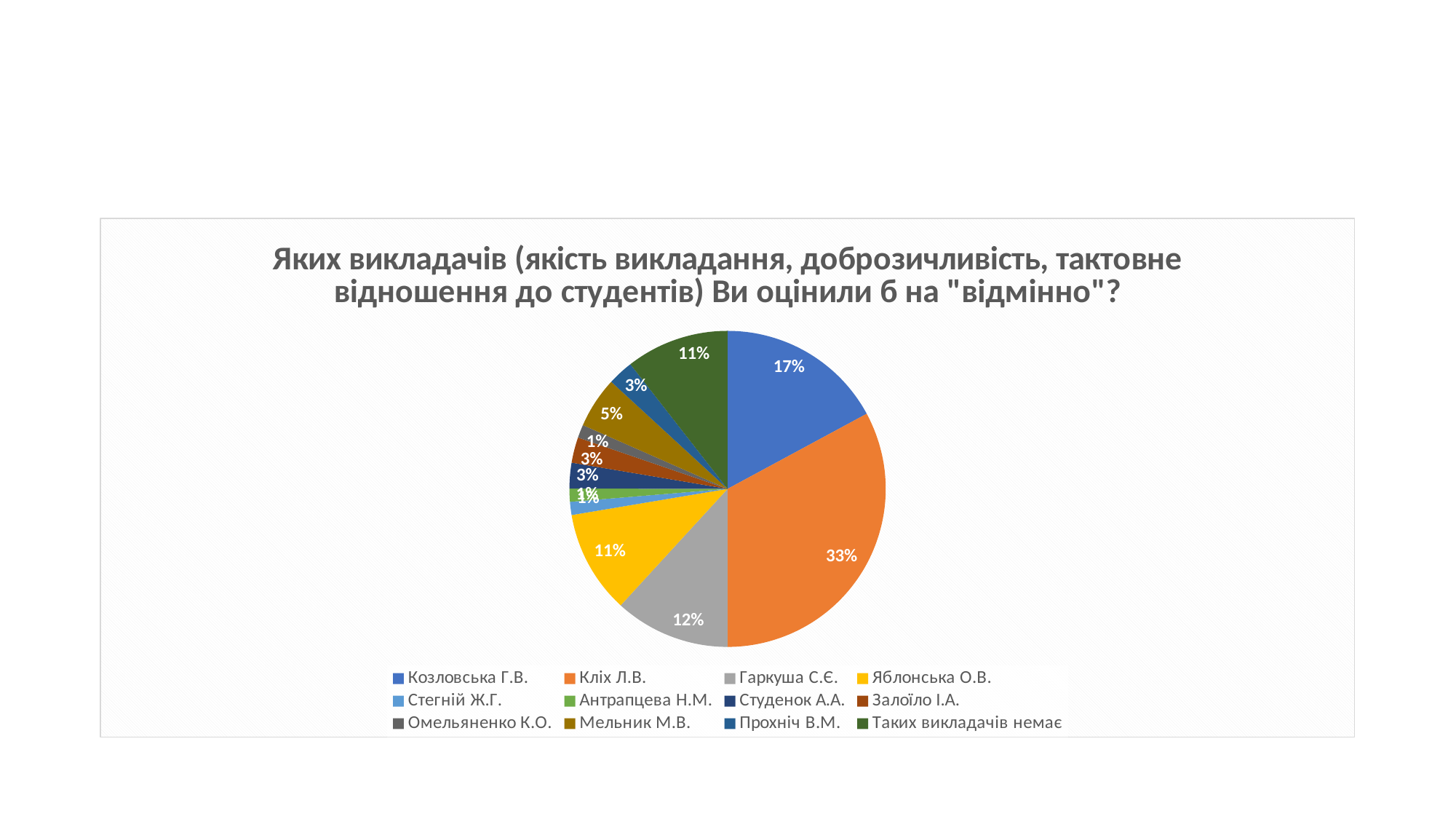
Which category has the largest slice of the pie? Кліх Л.В. What share of the pie does Кліх Л.В. have? 33% How many categories does the legend list? 12 What percentage is shown for Гаркуша С.Є.? 12% What percentage is shown for the slice "Таких викладачів немає"? 11% Which slice is larger: Козловська Г.В. or Мельник М.В.? Козловська Г.В. What is the difference in percentage points between the slices for Кліх Л.В. and Козловська Г.В.? 16 What share of the pie is labelled for Мельник М.В.? 5% Which slice is larger: Гаркуша С.Є. or Яблонська О.В.? Гаркуша С.Є. What is the title of the chart? Яких викладачів (якість викладання, доброзичливість, тактовне відношення до студентів) Ви оцінили б на "відмінно"? What percentage is shown for Козловська Г.В.? 17% What type of chart is shown on the slide? pie chart